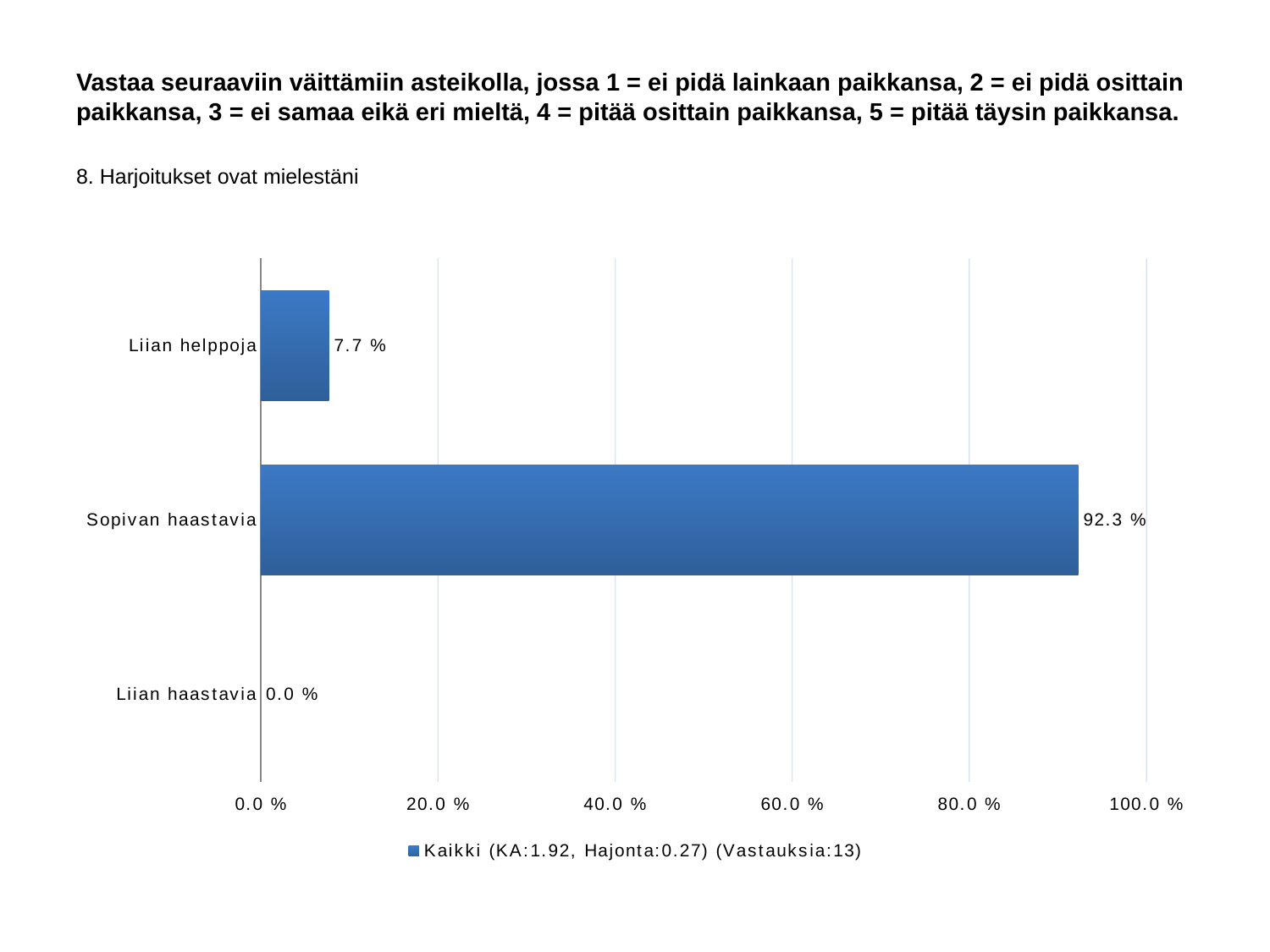
What is the difference between the values for "Sopivan haastavia" and "Liian helppoja"? 84.6 % Which category has the highest value? Sopivan haastavia What kind of chart is shown on the slide? bar chart How many series does the legend list? 1 How many categories are shown in the chart? 3 What is the value for "Liian haastavia"? 0.0 % What is the value for "Sopivan haastavia"? 92.3 % What is the value for "Liian helppoja"? 7.7 % Which category has the lowest value? Liian haastavia Is the value for "Sopivan haastavia" greater or less than 80.0 %? greater How many responses (Vastauksia) does the legend report? 13 Which is larger, the value for "Liian helppoja" or the value for "Sopivan haastavia"? Sopivan haastavia